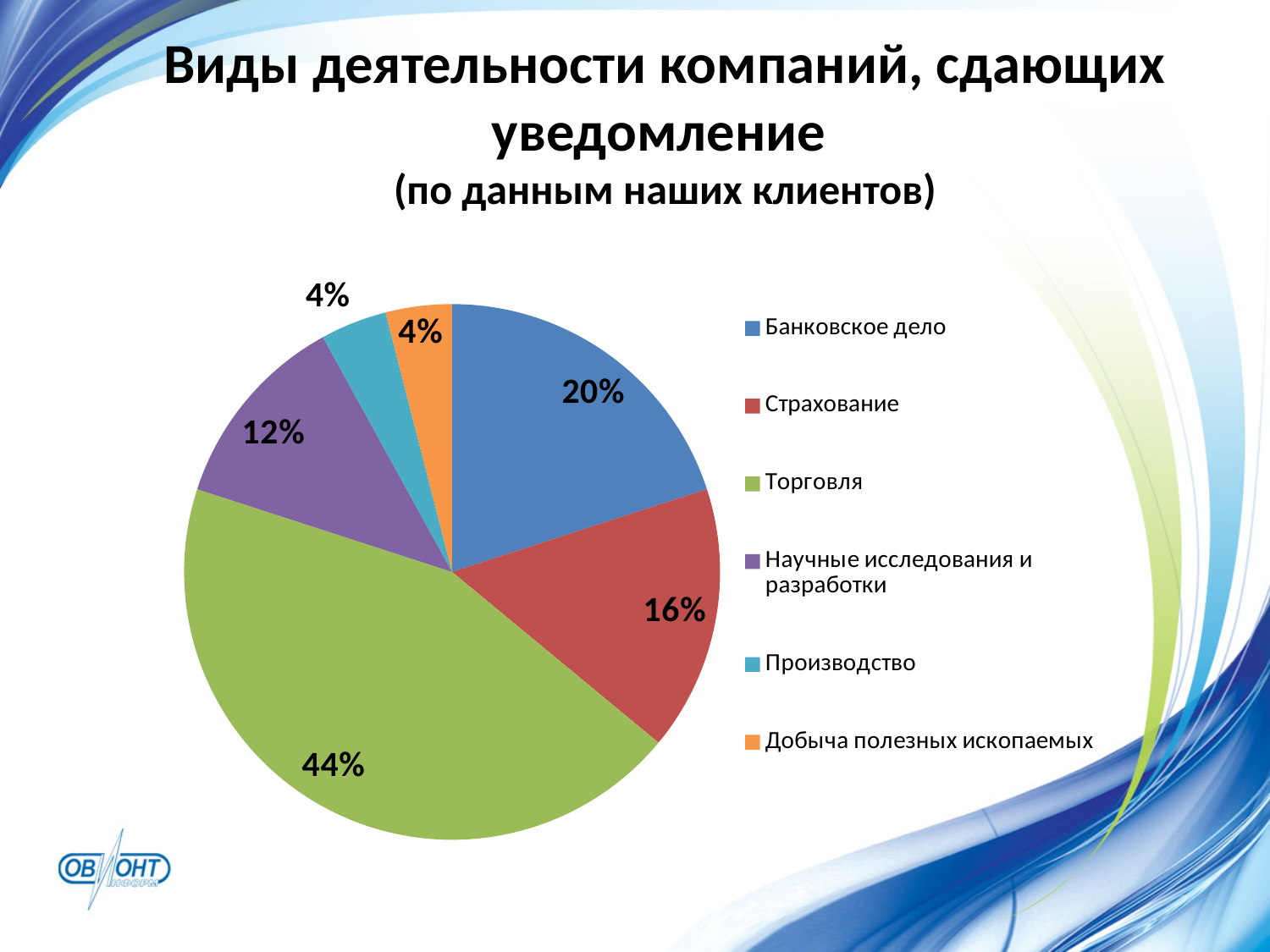
What is the difference in percentage points between Торговля and Банковское дело? 24 What type of chart is shown on the slide? pie chart What is the value shown for Производство? 4% What is the value shown for Страхование? 16% What colour is the slice for Добыча полезных ископаемых? orange Which category has the largest slice of the pie? Торговля Which is larger, the share for Страхование or the share for Научные исследования и разработки? Страхование How many categories does the legend list? 6 What share of the pie does Торговля account for? 44% How many categories have a share of 4%? 2 What is the value shown for Банковское дело? 20% What is the value shown for Научные исследования и разработки? 12%